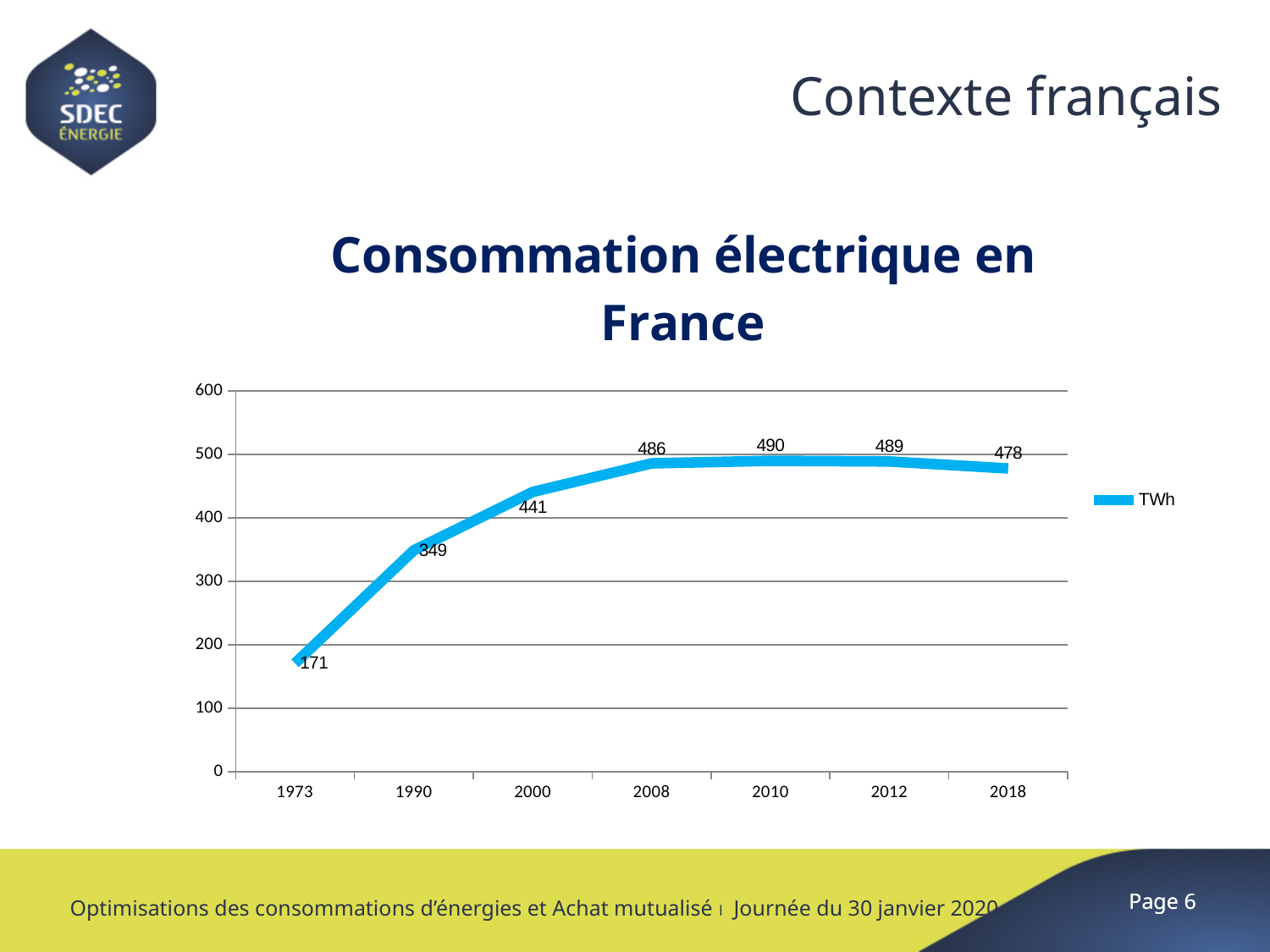
What kind of chart is shown? line chart What is the value for 2018? 478 Which year has the lowest value? 1973 What series name does the legend show? TWh What is the value for 1973? 171 What is the difference between the values for 1990 and 1973? 178 What is the difference between the values for 2010 and 2018? 12 How many years are plotted on the x axis? 7 Is the value for 1990 greater or less than 300? greater What is the value for 2000? 441 Which year has the highest value? 2010 Which is larger, the value for 2008 or the value for 2000? 2008